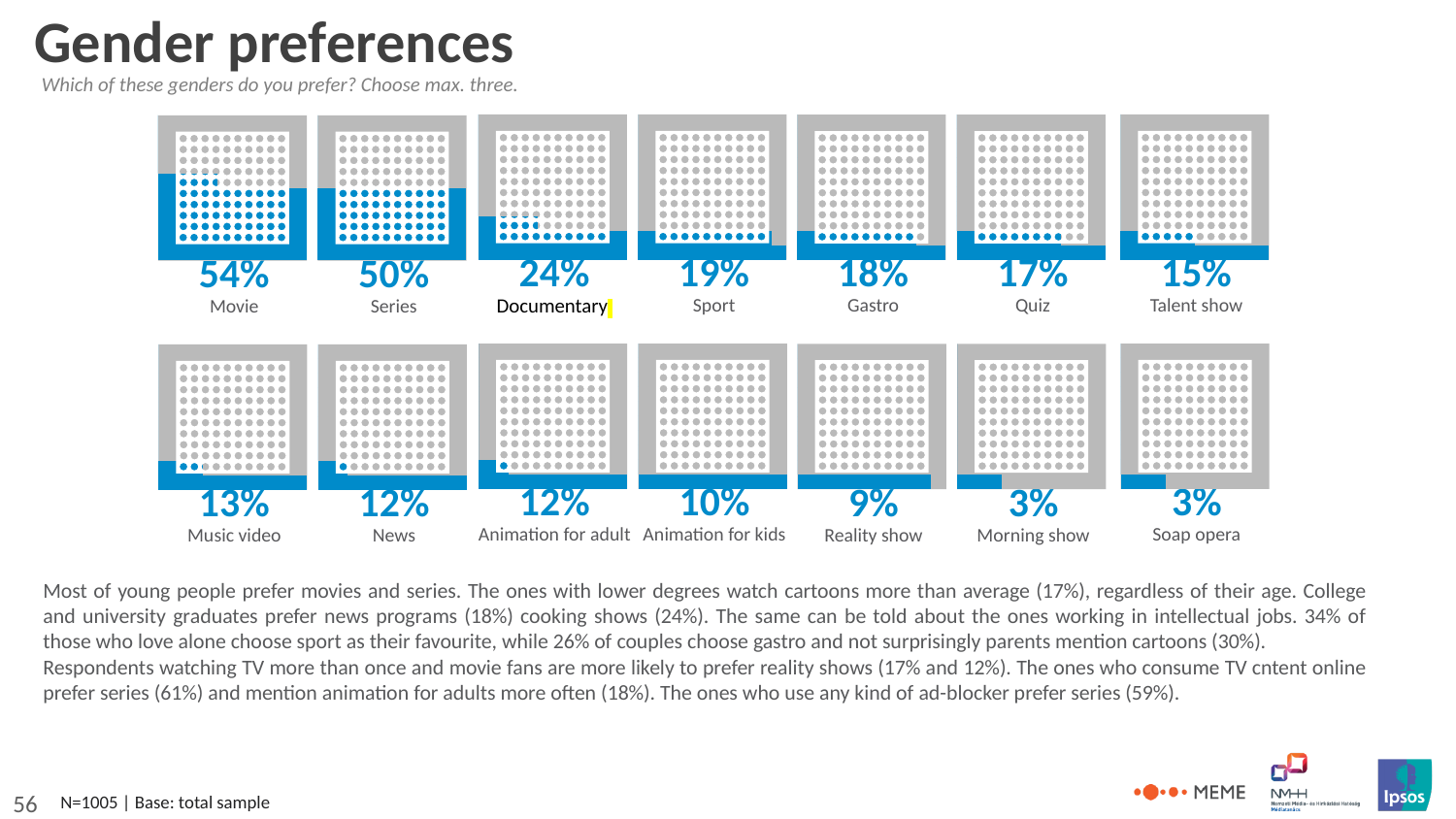
What is the value shown for Documentary? 24% How many genres are shown on the slide? 14 What is the difference between the percentages for Movie and Series? 4% What percentage is shown for Reality show? 9% Which two genres share the lowest percentage on the slide? Morning show and Soap opera Which has a higher percentage, Sport or Gastro? Sport What is the value for Animation for kids? 10% What is the difference between the values for Documentary and Sport? 5% What percentage of respondents prefer Movie? 54% What is the title of the slide containing these charts? Gender preferences Which genre has the highest percentage? Movie Do the percentages rise or fall when reading the genres from left to right across the two rows? Fall